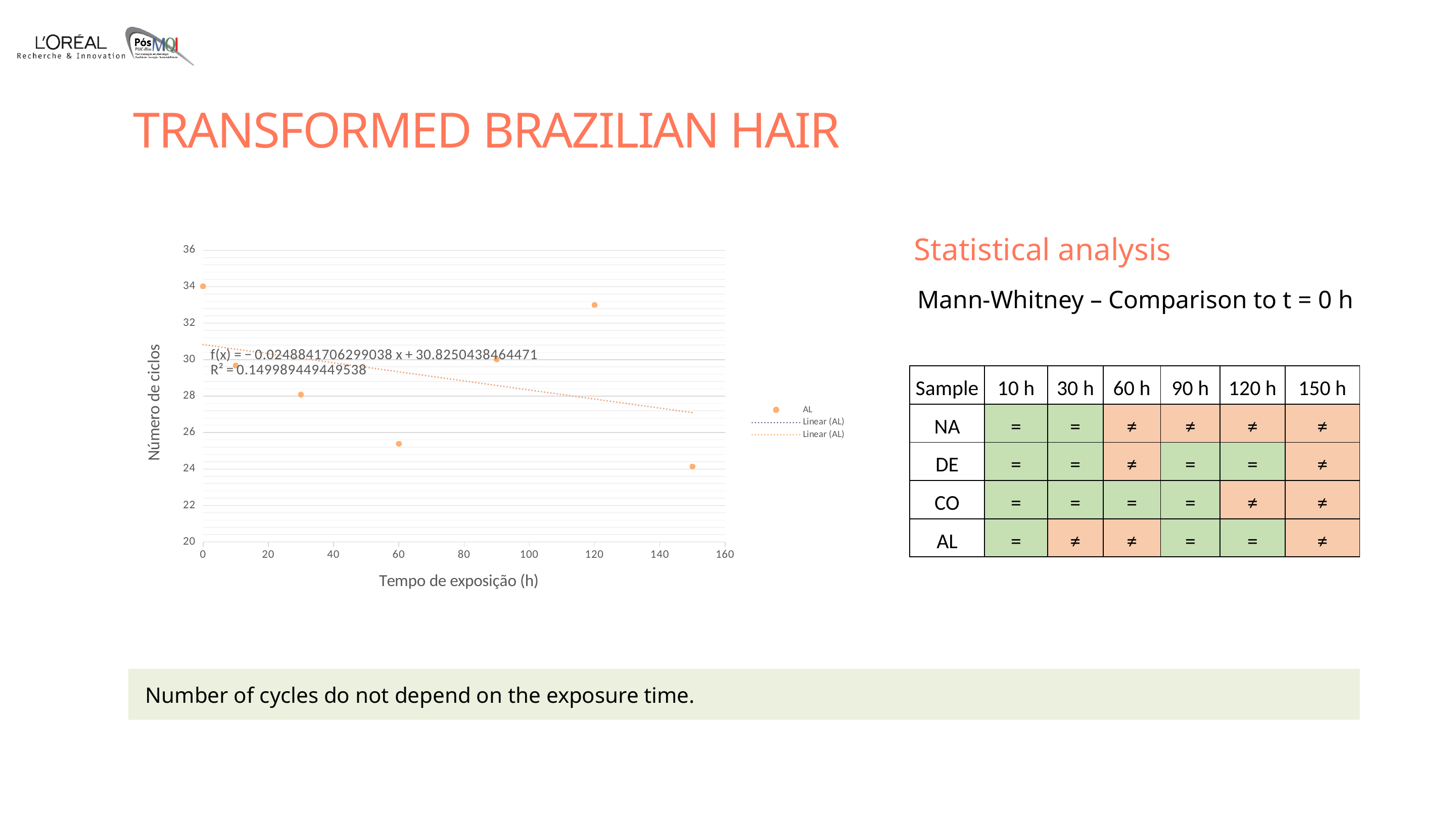
Which has a higher number of cycles, 0 h or 60 h? 0 h What is the label on the x axis of the scatter chart? Tempo de exposição (h) Is the value for 60 h greater or less than 26? less How many entries does the legend of the scatter chart list? 3 Is the value for 150 h greater or less than 26? less How many data points are plotted in the scatter chart? 7 What kind of chart is shown on the left of the slide? scatter chart What is the label on the y axis of the scatter chart? Número de ciclos Is the value for 0 h greater or less than 32? greater Which exposure time has the lowest number of cycles? 150 h Does the linear trendline rise or fall as exposure time increases? fall